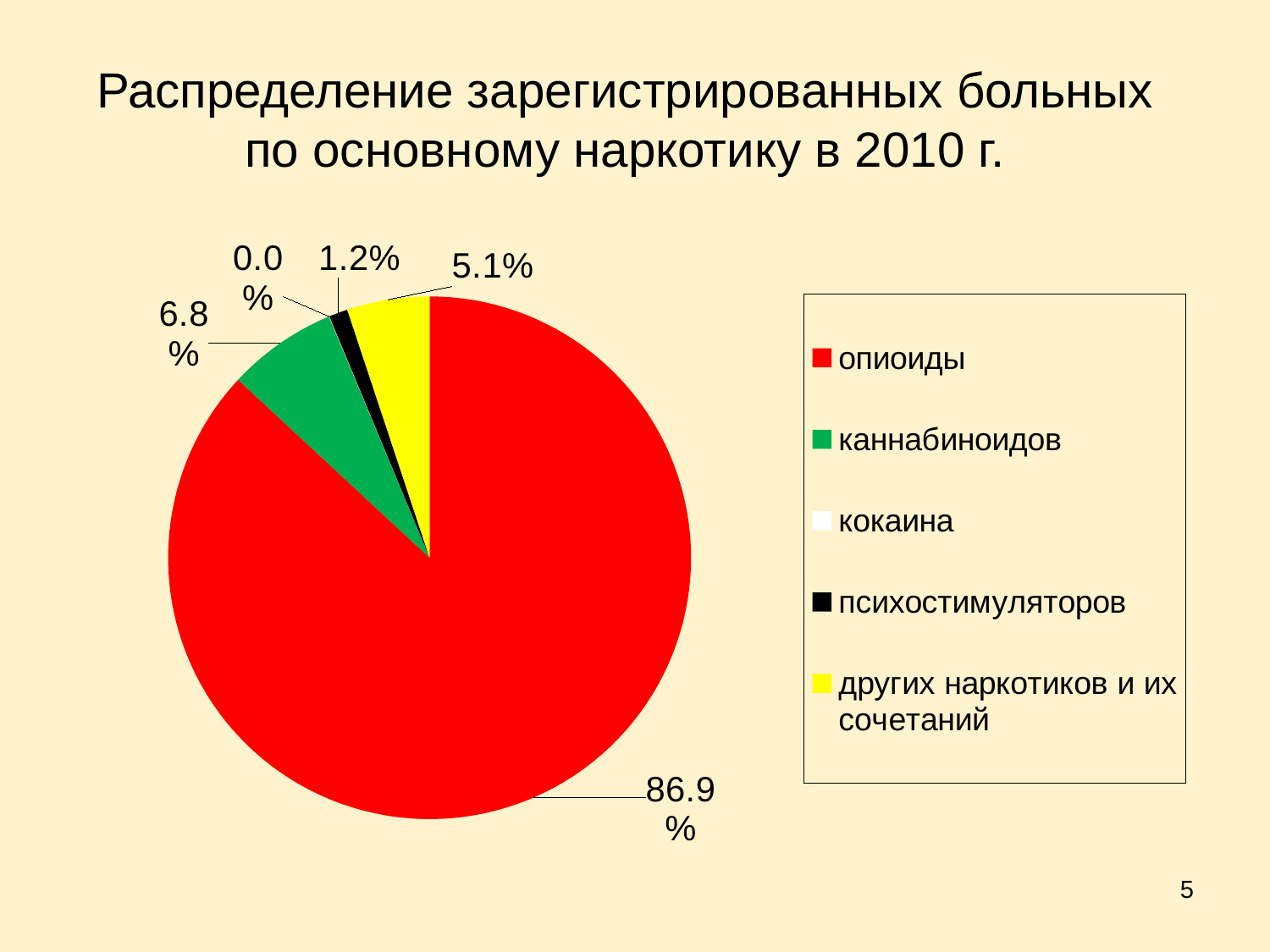
Which category has the largest slice of the pie? опиоиды What is the value shown for других наркотиков и их сочетаний? 5.1% How many categories does the legend list? 5 What is the value shown for каннабиноидов? 6.8% Which is larger: the share of каннабиноидов or the share of психостимуляторов? каннабиноидов What colour is the slice for опиоиды? red What share of the pie does опиоиды account for? 86.9% What type of chart is shown on the slide? pie chart What is the difference between the shares of каннабиноидов and других наркотиков и их сочетаний? 1.7% What is the value shown for кокаина? 0.0% Which category has the smallest slice of the pie? кокаина What is the value shown for психостимуляторов? 1.2%